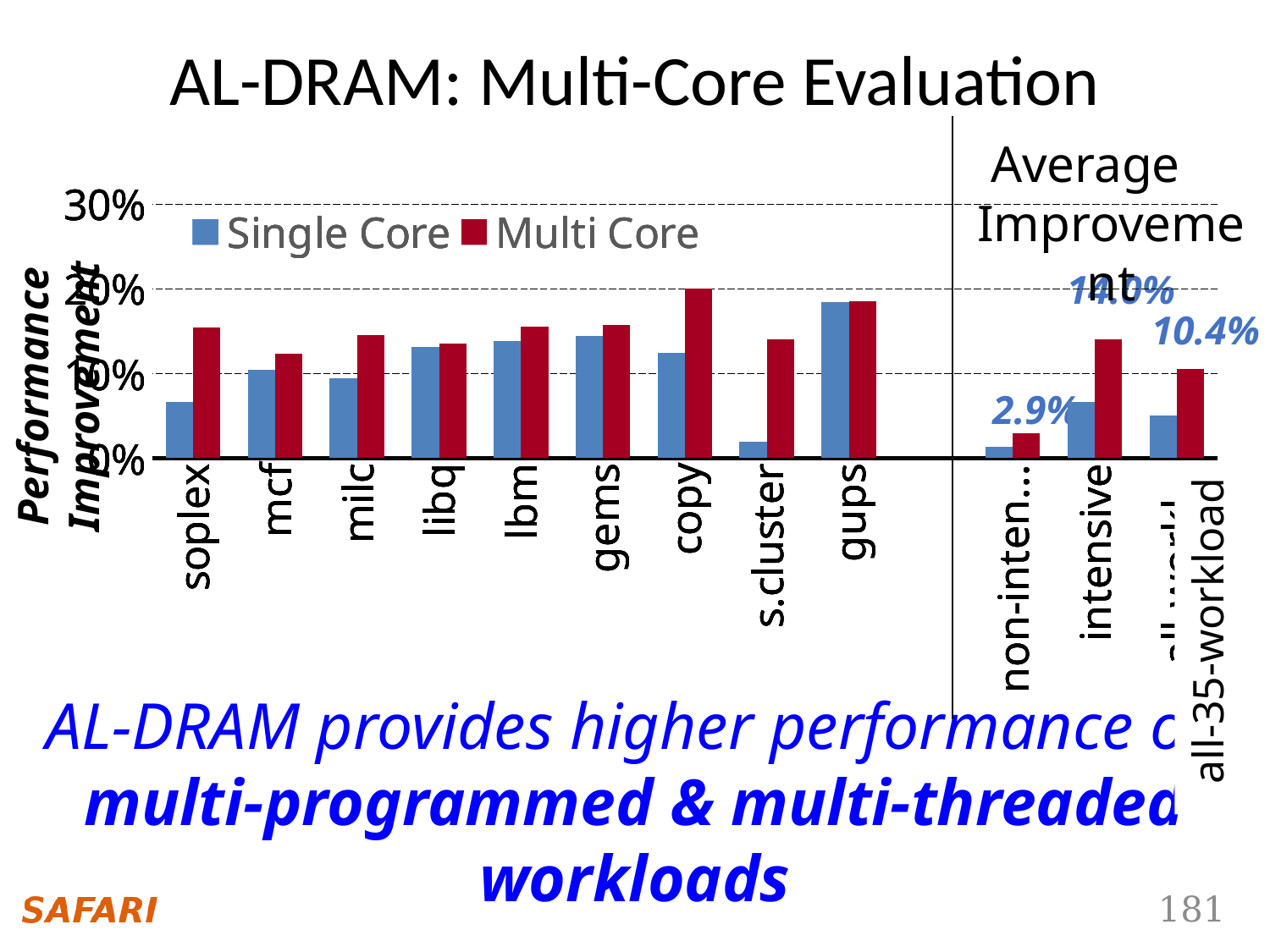
Is the Single Core value for gups greater or less than 10%? greater What kind of chart is shown on the slide? bar chart Is the Single Core value for s.cluster greater or less than 10%? less How many benchmark categories are shown to the left of the vertical divider line? 9 Which benchmark has the highest Multi Core bar? copy For soplex, which is larger: the Single Core or the Multi Core bar? Multi Core What are the two series named in the legend? Single Core and Multi Core For copy, which is larger: the Single Core or the Multi Core bar? Multi Core How many series does the legend list? 2 What value is labelled above the non-intensive bars? 2.9% What is the Multi Core value labelled for all-35-workload? 10.4% Which benchmark has the highest Single Core bar? gups